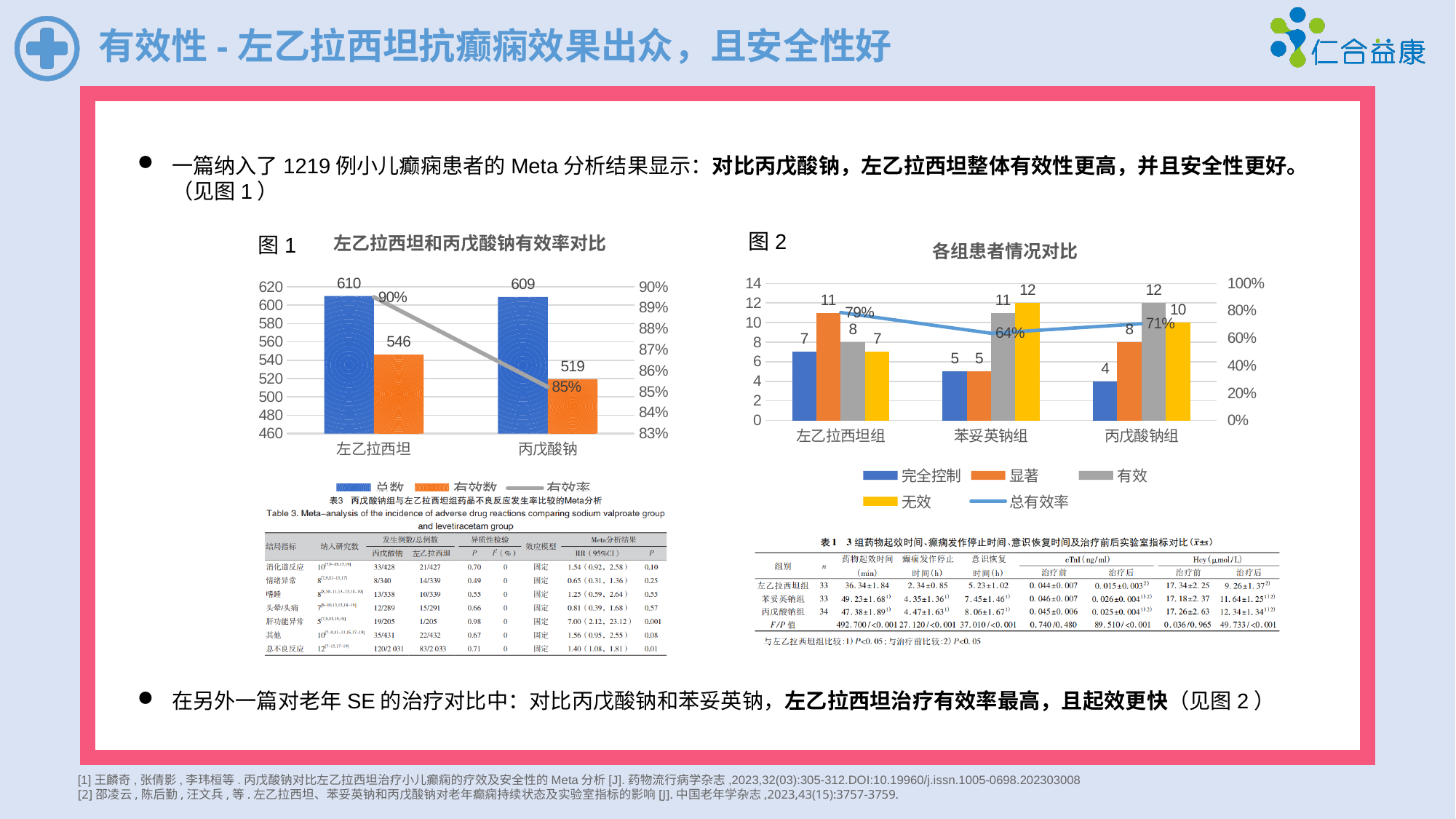
In the chart titled 左乙拉西坦和丙戊酸钠有效率对比 (图 1), how many series does the legend list? 3 In the chart titled 各组患者情况对比 (图 2), what is the 显著 value for 左乙拉西坦组? 11 In the chart titled 各组患者情况对比 (图 2), what is the difference between the 无效 values of 苯妥英钠组 and 左乙拉西坦组? 5 In the chart titled 各组患者情况对比 (图 2), how many series does the legend list? 5 In the chart titled 左乙拉西坦和丙戊酸钠有效率对比 (图 1), what is the 有效数 value for 左乙拉西坦? 546 In the chart titled 左乙拉西坦和丙戊酸钠有效率对比 (图 1), what is the difference between the 有效数 values of 左乙拉西坦 and 丙戊酸钠? 27 In the chart titled 左乙拉西坦和丙戊酸钠有效率对比 (图 1), which category has the higher 有效率? 左乙拉西坦 In the chart titled 各组患者情况对比 (图 2), how many groups are shown on the x axis? 3 In the chart titled 各组患者情况对比 (图 2), what is the 总有效率 for 苯妥英钠组? 64% In the chart titled 左乙拉西坦和丙戊酸钠有效率对比 (图 1), what is the 有效率 for 丙戊酸钠? 85% In the chart titled 各组患者情况对比 (图 2), which group has the lowest 完全控制 value? 丙戊酸钠组 In the chart titled 各组患者情况对比 (图 2), which group has the highest 总有效率? 左乙拉西坦组